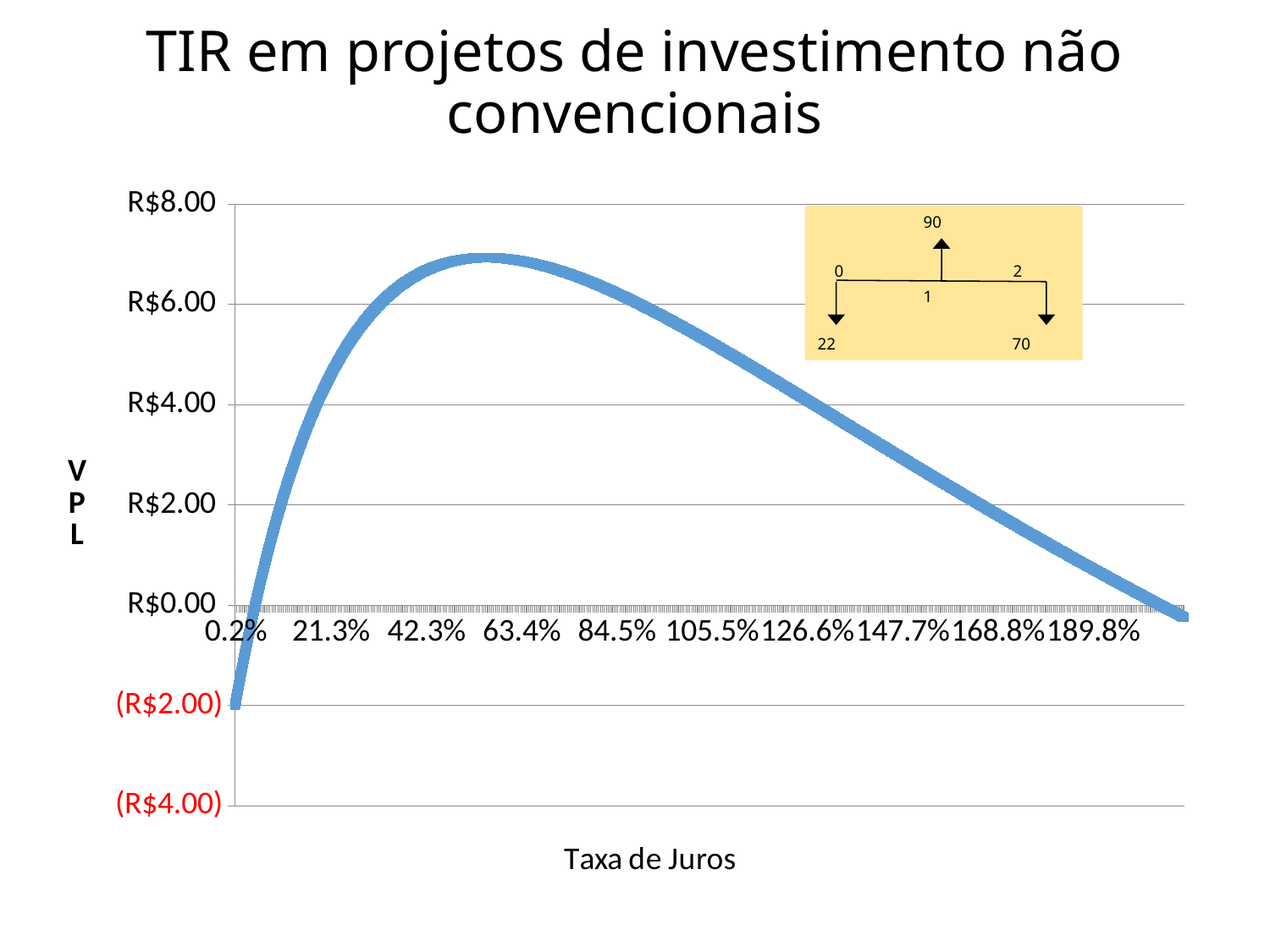
Is the VPL value at 63.4% greater or less than R$6.00? greater Is the VPL value at 42.3% larger or smaller than the VPL value at 168.8%? larger What kind of chart is shown on the slide? line chart Is the VPL value at 147.7% greater or less than R$4.00? less Is the VPL value at 189.8% greater or less than R$2.00? less Does the VPL rise or fall as the interest rate increases from 0.2% to 42.3%? rise Does the VPL rise or fall as the interest rate increases from 63.4% to 189.8%? fall How many tick labels are shown on the horizontal axis? 10 What is the title of the slide's chart? TIR em projetos de investimento não convencionais What is the label of the horizontal axis? Taxa de Juros